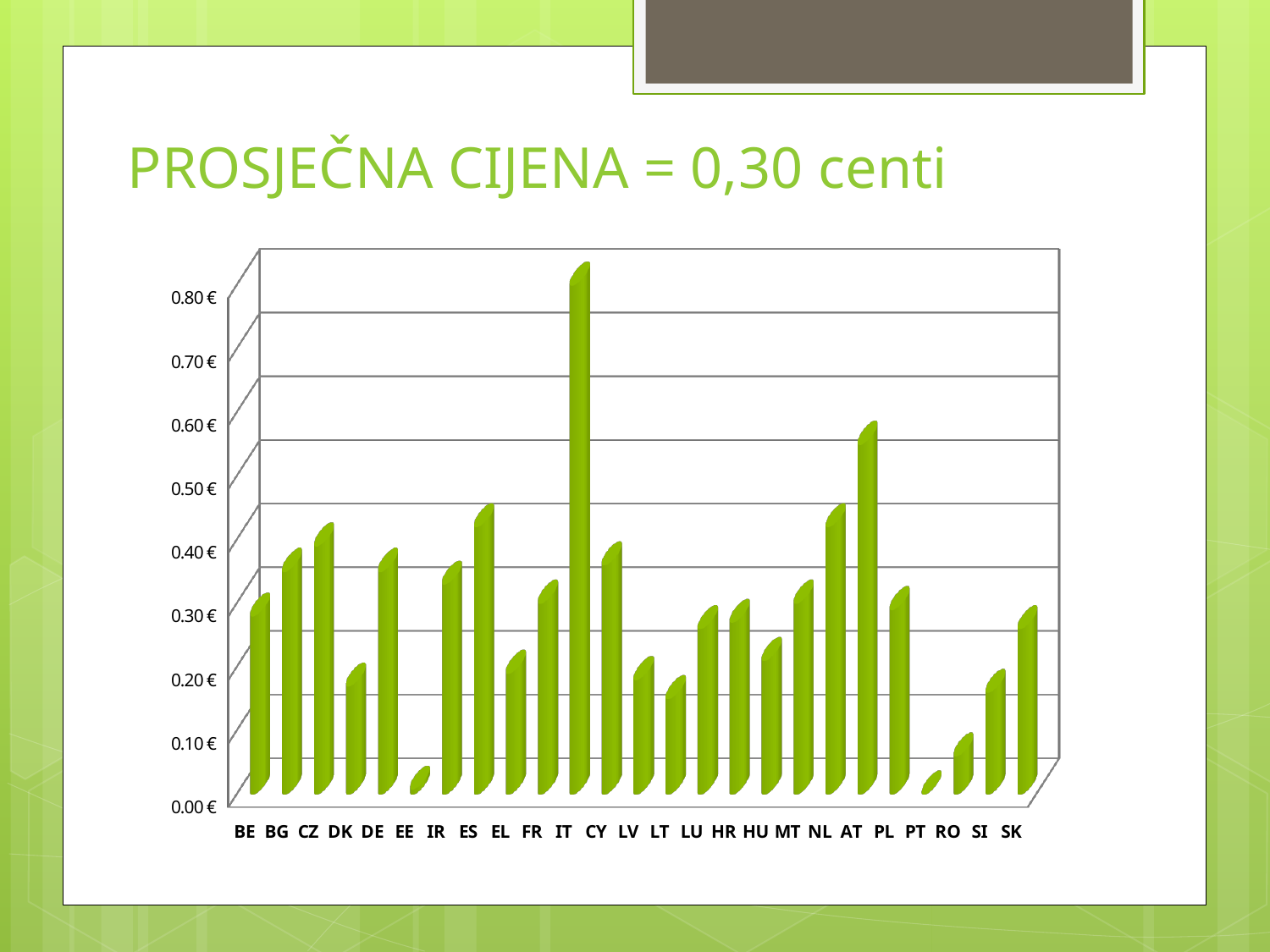
Is the value for EE greater or less than 0.10 €? less What is the title of the slide containing the chart? PROSJEČNA CIJENA = 0,30 centi Which country has the highest bar in the chart? IT Is the value for AT greater or less than 0.50 €? greater Which has the larger value, AT or NL? AT Is the value for IT greater or less than 0.70 €? greater Which has the larger value, ES or LV? ES Which has the larger value, RO or BE? BE What kind of chart is shown on the slide? bar chart How many countries are shown on the x axis of the chart? 25